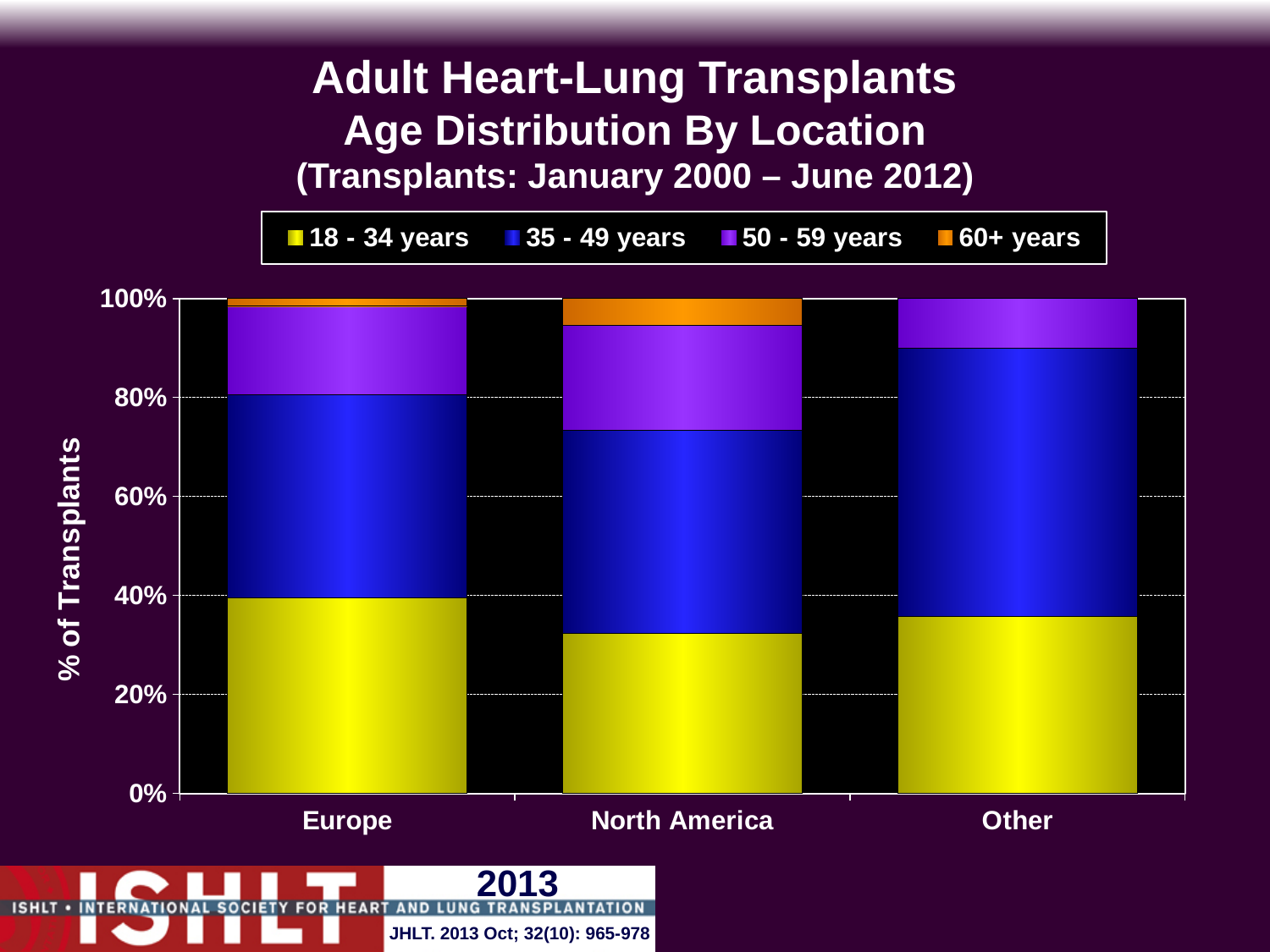
Which location has the smallest 50 - 59 years share? Other How many age-group series does the legend list? 4 Is the 18 - 34 years share for North America greater or less than 40%? less What is the label of the y axis? % of Transplants Is the cumulative top of the 35 - 49 years segment for North America greater or less than 80%? less What kind of chart is shown on the slide? Stacked bar chart What does each stacked bar total on the y axis? 100% How many locations are shown on the x axis of the chart? 3 Is the cumulative top of the 35 - 49 years segment for Other greater or less than 80%? greater Which location has the largest 60+ years share? North America What is the title of the chart? Adult Heart-Lung Transplants Age Distribution By Location (Transplants: January 2000 – June 2012)